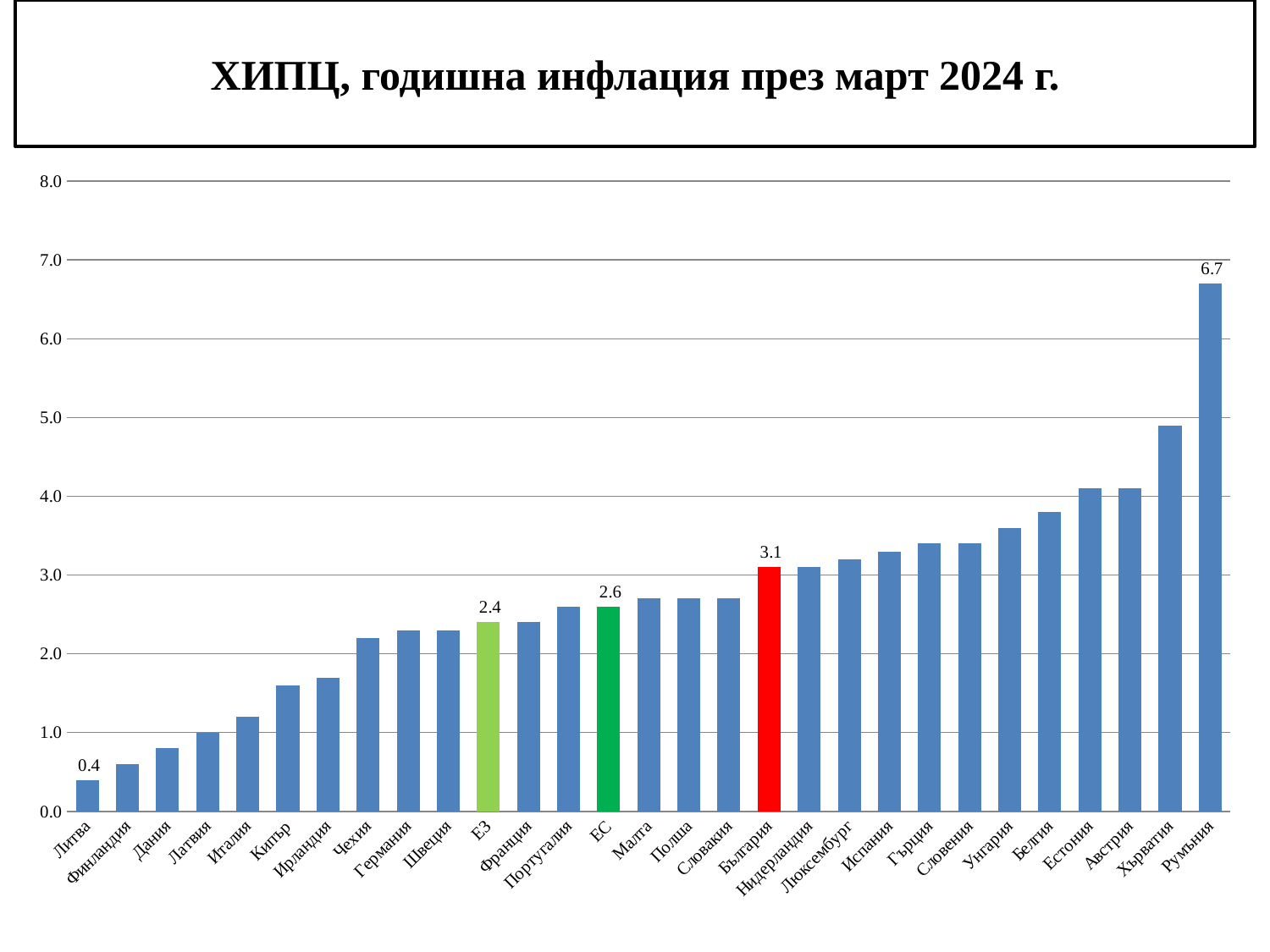
Which category has the highest value? Румъния Is the value for Финландия greater or less than 1.0? less Which category has the lowest value? Литва How many categories are shown on the x axis? 29 Which is larger, the value for България or the value for ЕС? България What is the value for България? 3.1 Is the value for Хърватия greater or less than 4.0? greater What is the value for Румъния? 6.7 What is the difference between the values for ЕС and ЕЗ? 0.2 What is the value for ЕЗ? 2.4 What is the difference between the values for Румъния and България? 3.6 What kind of chart is this? bar chart